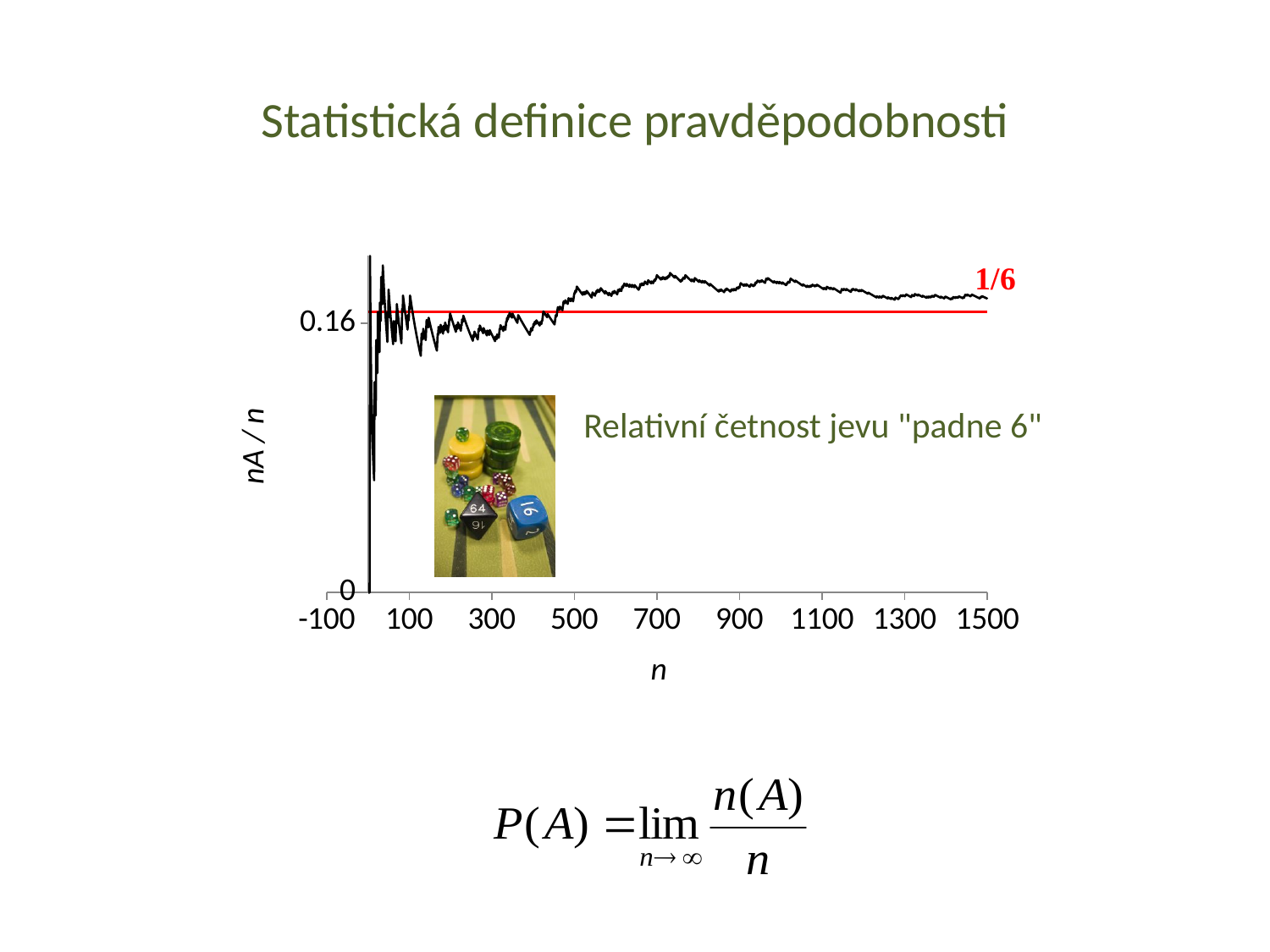
What value is the red horizontal reference line labelled with? 1/6 What is the label of the x axis of the chart? n Does the plotted line fluctuate more strongly at small n or at large n? small n Is the plotted value of nA / n at n = 1000 greater or less than 0.16? greater What kind of chart is shown on the slide? line chart Which y-axis tick value other than 0 is printed on the chart? 0.16 What is the label of the y axis of the chart? nA / n Is the plotted value of nA / n at n = 300 greater or less than 0.16? less What is the highest tick value shown on the x axis? 1500 What is the lowest tick value shown on the x axis? -100 Is the plotted value of nA / n at n = 700 greater or less than 0.16? greater